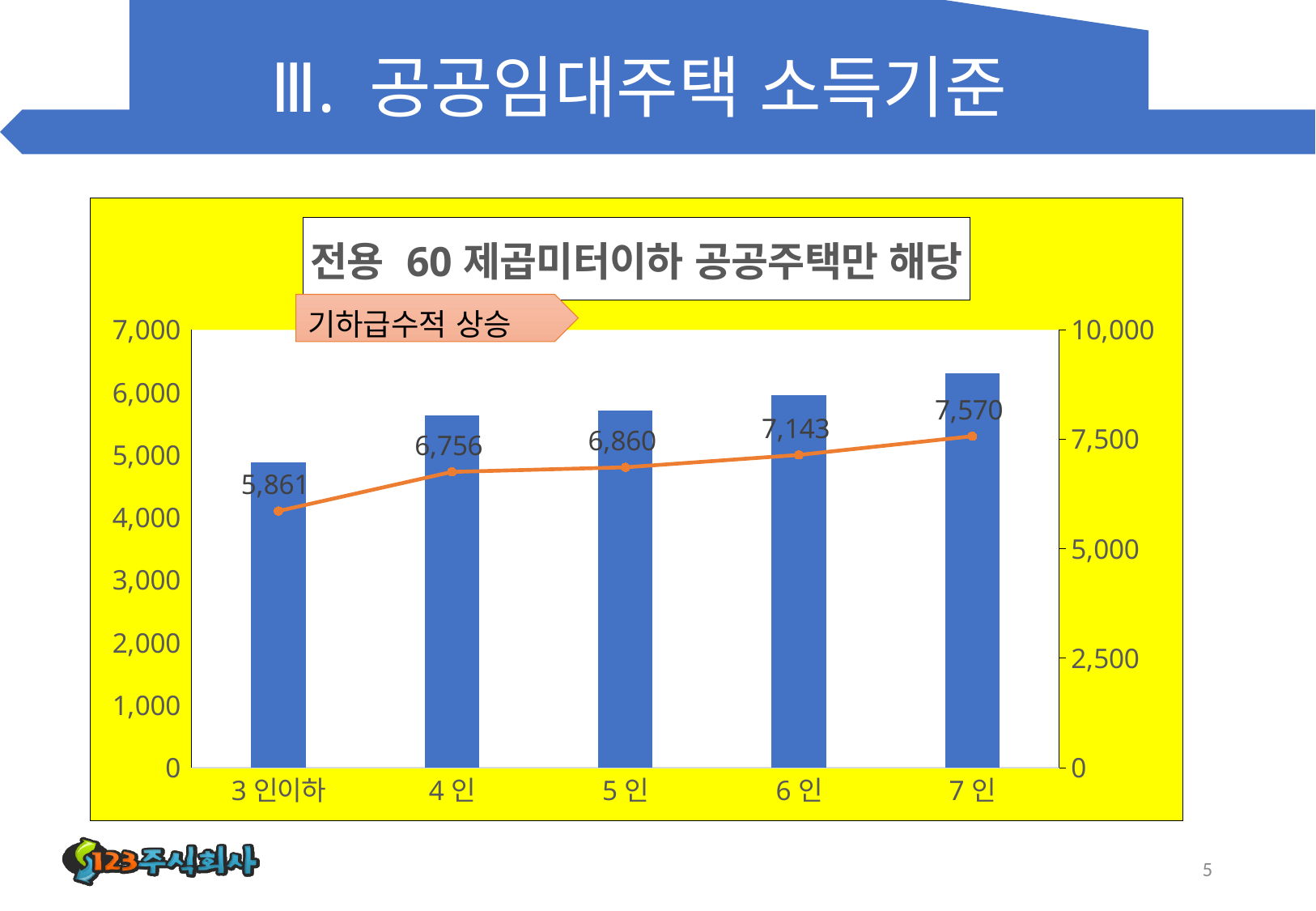
How many categories are shown on the x axis? 5 What is the difference between the line values for 7 인 and 3 인이하? 1,709 What is the value of the line data label for 5 인? 6,860 What is the value of the line data label for 7 인? 7,570 Which has the larger line value, 4 인 or 6 인? 6 인 What is the value of the line data label for 3 인이하? 5,861 Which category has the highest value on the orange line? 7 인 Which category has the lowest value on the orange line? 3 인이하 Is the bar for 7 인 greater or less than 6,000 on the left axis? greater What is the difference between the line values for 6 인 and 5 인? 283 Do the values on the orange line rise or fall from 3 인이하 to 7 인? rise